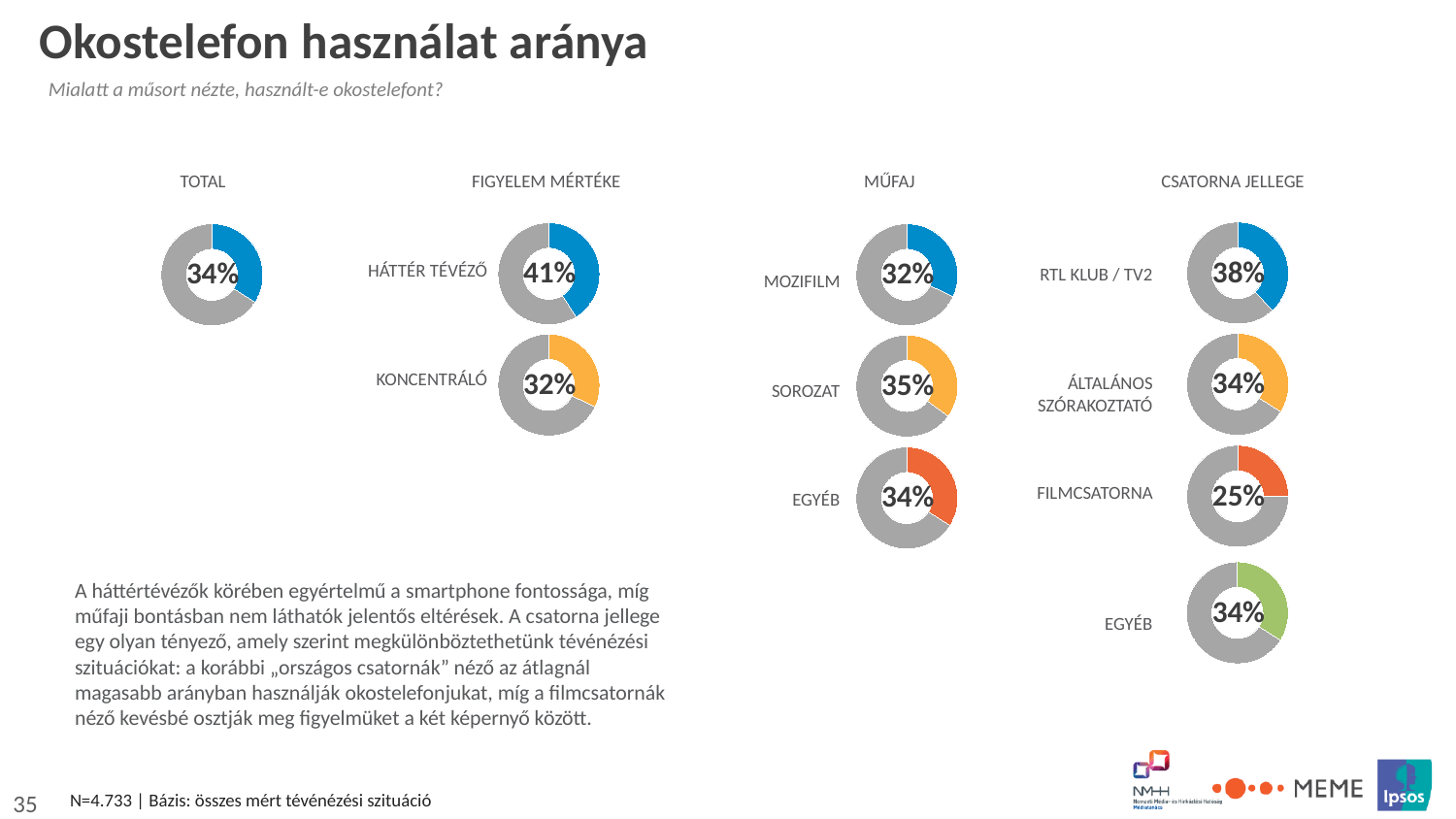
In the TOTAL donut chart, what percentage is shown? 34% In the FIGYELEM MÉRTÉKE group, what value is shown for HÁTTÉR TÉVÉZŐ? 41% In the CSATORNA JELLEGE group, which category has the highest value? RTL KLUB / TV2 In the CSATORNA JELLEGE group, which is larger: the value for RTL KLUB / TV2 or the value for FILMCSATORNA? RTL KLUB / TV2 In the FIGYELEM MÉRTÉKE group, what value is shown for KONCENTRÁLÓ? 32% In the FIGYELEM MÉRTÉKE group, what is the difference between the HÁTTÉR TÉVÉZŐ and KONCENTRÁLÓ values? 9 percentage points In the CSATORNA JELLEGE group, what is the difference between the RTL KLUB / TV2 and FILMCSATORNA values? 13 percentage points In the MŰFAJ group, which category has the lowest value? MOZIFILM How many donut charts are shown in the CSATORNA JELLEGE group? 4 What type of chart is used to show the TOTAL value? Donut chart In the CSATORNA JELLEGE group, what value is shown for FILMCSATORNA? 25% In the MŰFAJ group, what value is shown for SOROZAT? 35%